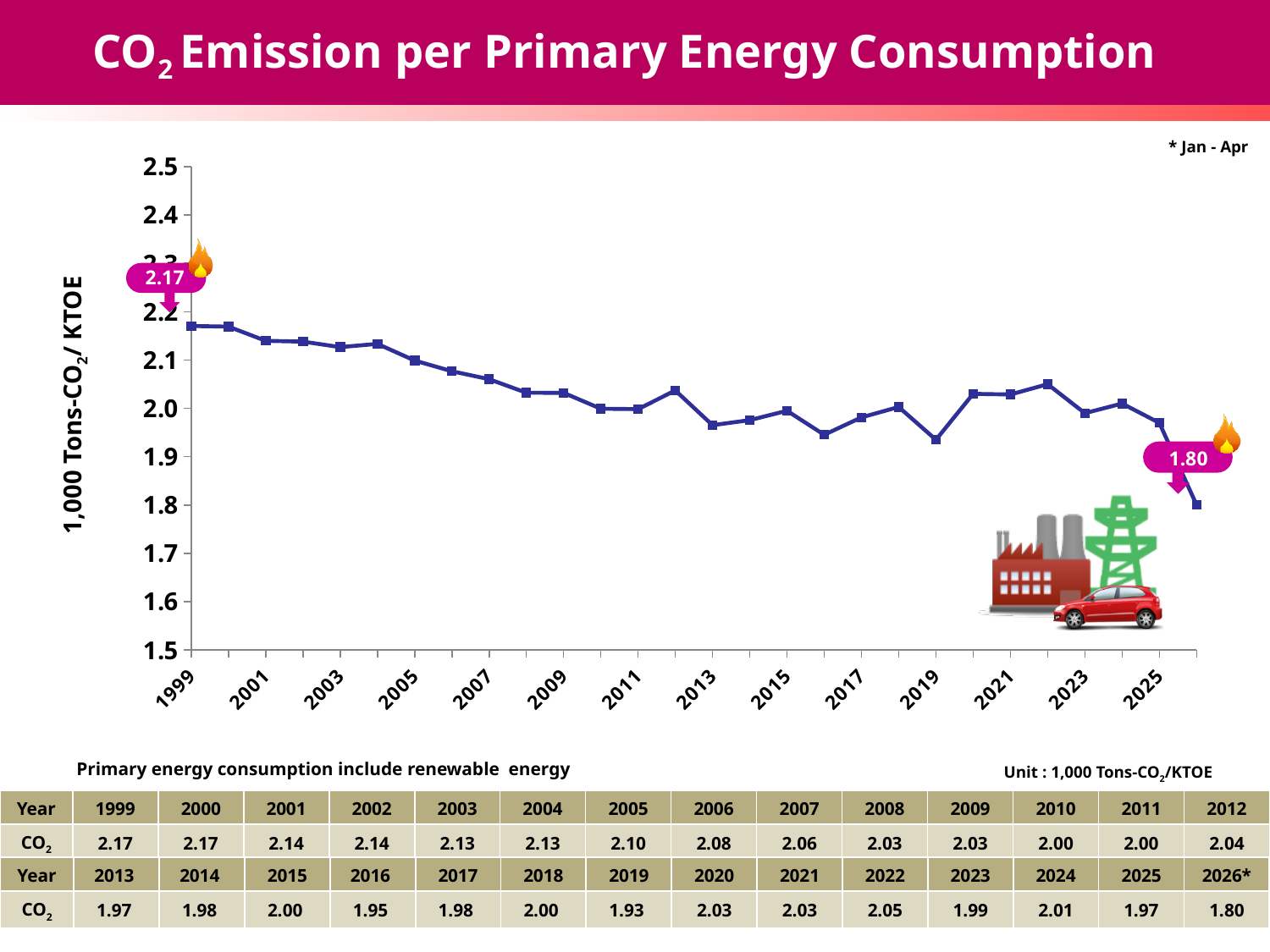
What type of chart is shown on the slide? line chart What is the CO2 emission per primary energy consumption value for 1999? 2.17 Which year has the lowest value on the chart? 2026* How many years are plotted on the chart? 28 Do the values generally rise or fall from 1999 to 2026*? fall What is the difference between the 1999 value and the 2026* value? 0.37 What is the value for 2012? 2.04 Is the value for 2022 greater or less than 2.0? greater What is the value shown for 2026*? 1.80 Which is larger, the value for 2012 or the value for 2019? 2012 What is the highest value plotted on the chart? 2.17 What is the value for 2019? 1.93